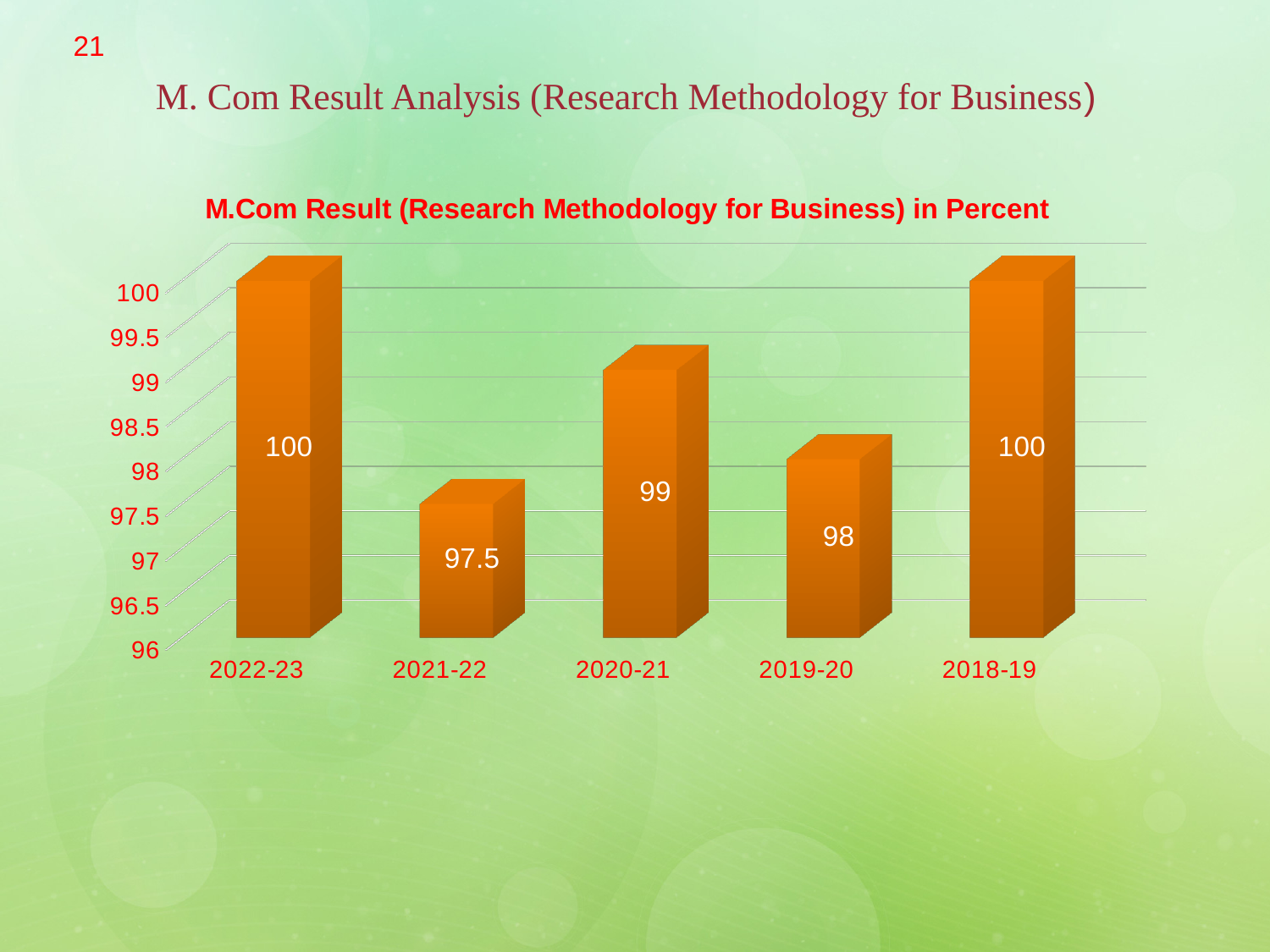
What is the difference between the values for 2022-23 and 2019-20? 2 Which is larger, the value for 2020-21 or the value for 2019-20? 2020-21 Which year has the lowest value? 2021-22 What is the value for 2020-21? 99 What kind of chart is shown on the slide? bar chart What is the title of the chart? M.Com Result (Research Methodology for Business) in Percent What is the value for 2021-22? 97.5 What is the value for 2022-23? 100 How many years are shown on the chart? 5 Is the value for 2021-22 greater or less than 98? less What is the difference between the values for 2020-21 and 2021-22? 1.5 What is the value for 2019-20? 98